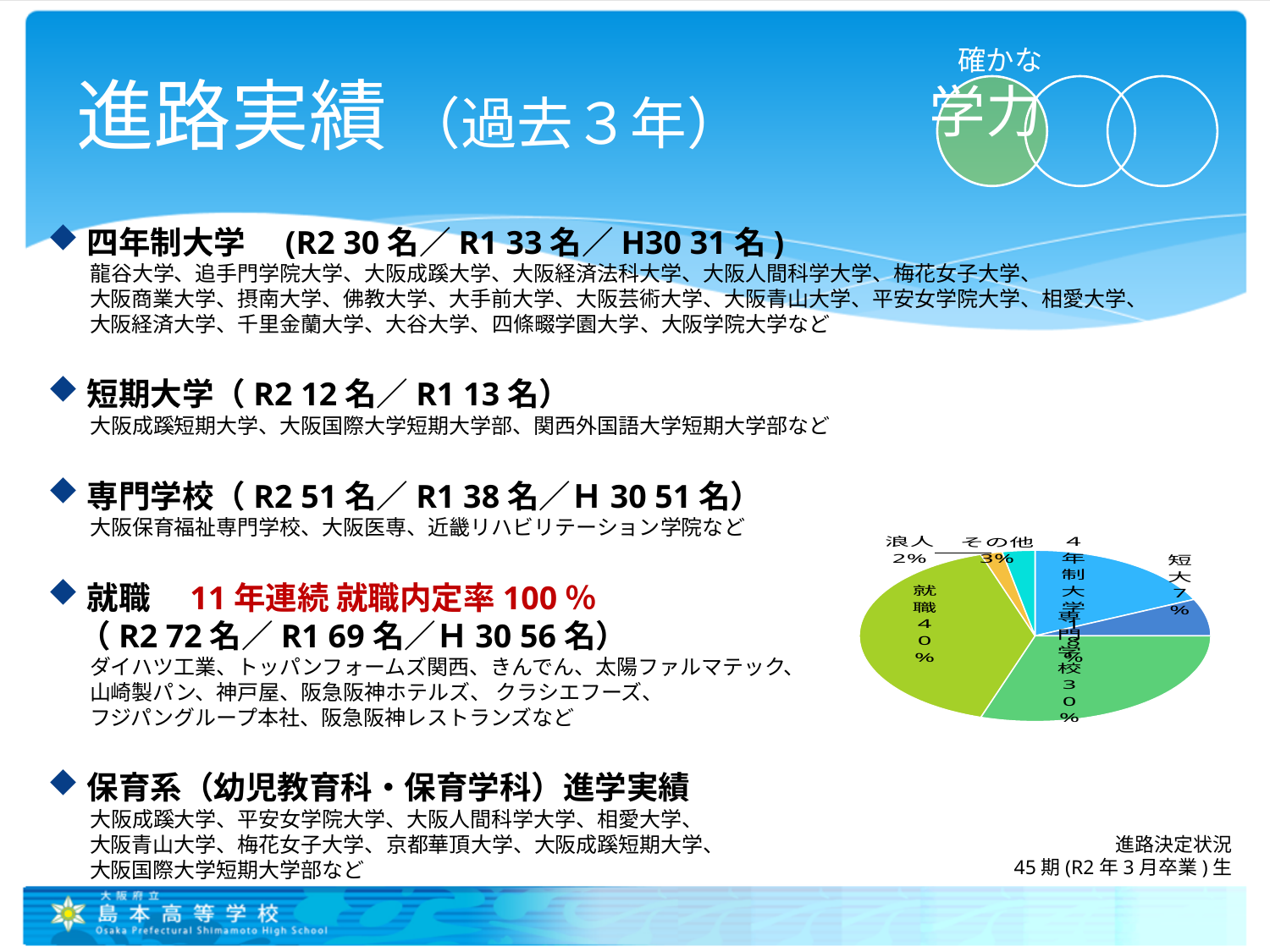
Which category has the smallest share in the pie chart? 浪人 What is the caption shown below the pie chart? 進路決定状況 45期(R2年3月卒業)生 Which category has the largest share in the pie chart? 就職 What is the difference in percentage points between 就職 and 専門学校 in the pie chart? 10 What percentage of the pie chart is 専門学校? 30% What percentage of the pie chart is 浪人? 2% What percentage of the pie chart is その他? 3% How many slices does the pie chart have? 6 What kind of chart is shown on the slide? pie chart What percentage of the pie chart is 短大? 7% Which is larger in the pie chart, 就職 or 専門学校? 就職 What percentage of the pie chart is 就職? 40%